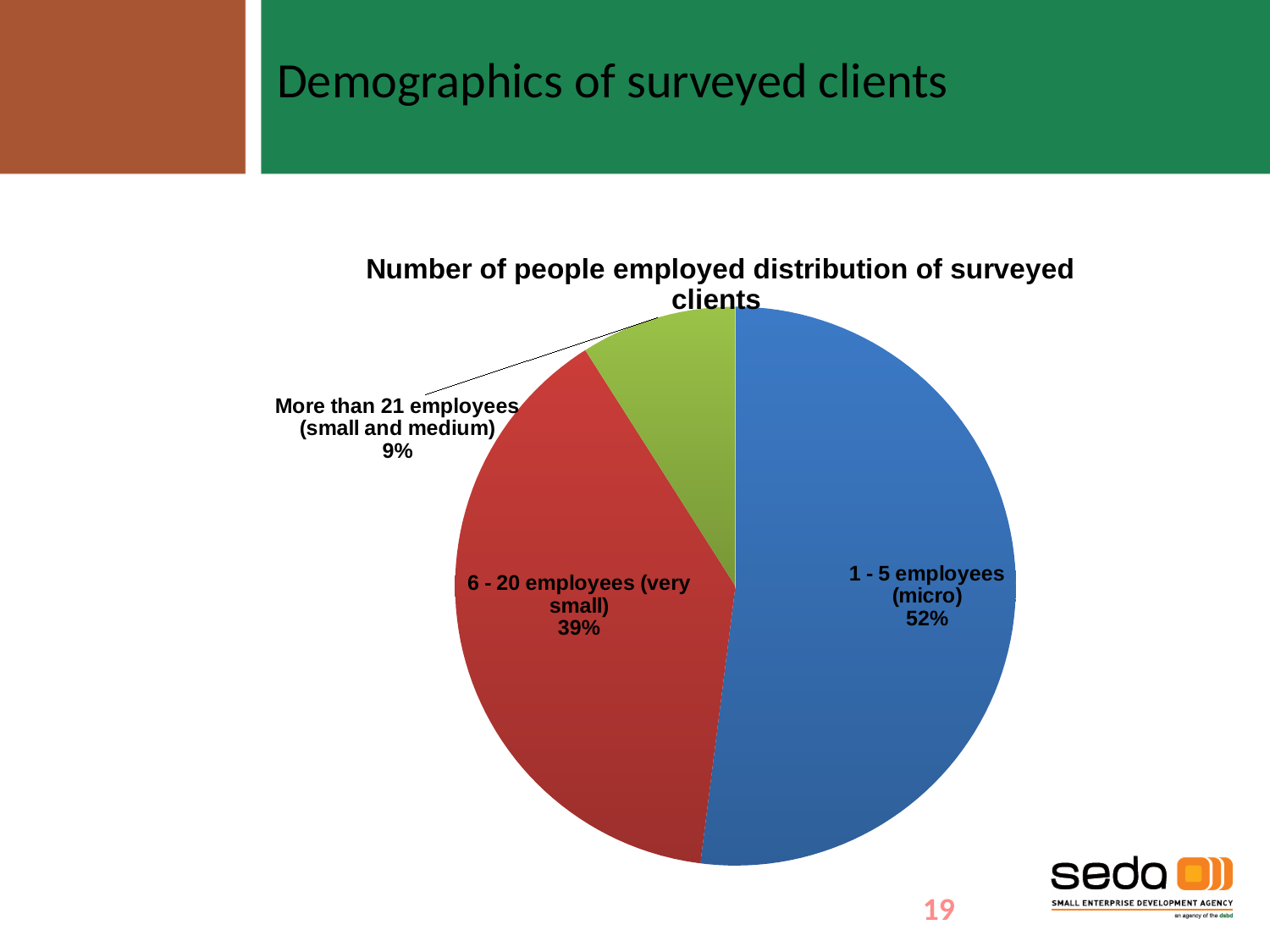
What share of surveyed clients have 1 - 5 employees (micro)? 52% How many slices does the pie chart have? 3 Which category has the largest share of the pie? 1 - 5 employees (micro) Is the share for 1 - 5 employees (micro) greater or less than 50%? greater What is the chart's title? Number of people employed distribution of surveyed clients What colour is the slice for 6 - 20 employees (very small)? Red What share of surveyed clients have more than 21 employees (small and medium)? 9% Which category has the smallest share of the pie? More than 21 employees (small and medium) What is the difference in percentage points between the 1 - 5 employees (micro) slice and the 6 - 20 employees (very small) slice? 13 percentage points What share of surveyed clients have 6 - 20 employees (very small)? 39% Which is larger: the share for 6 - 20 employees (very small) or the share for more than 21 employees (small and medium)? 6 - 20 employees (very small) What kind of chart is shown on the slide? Pie chart